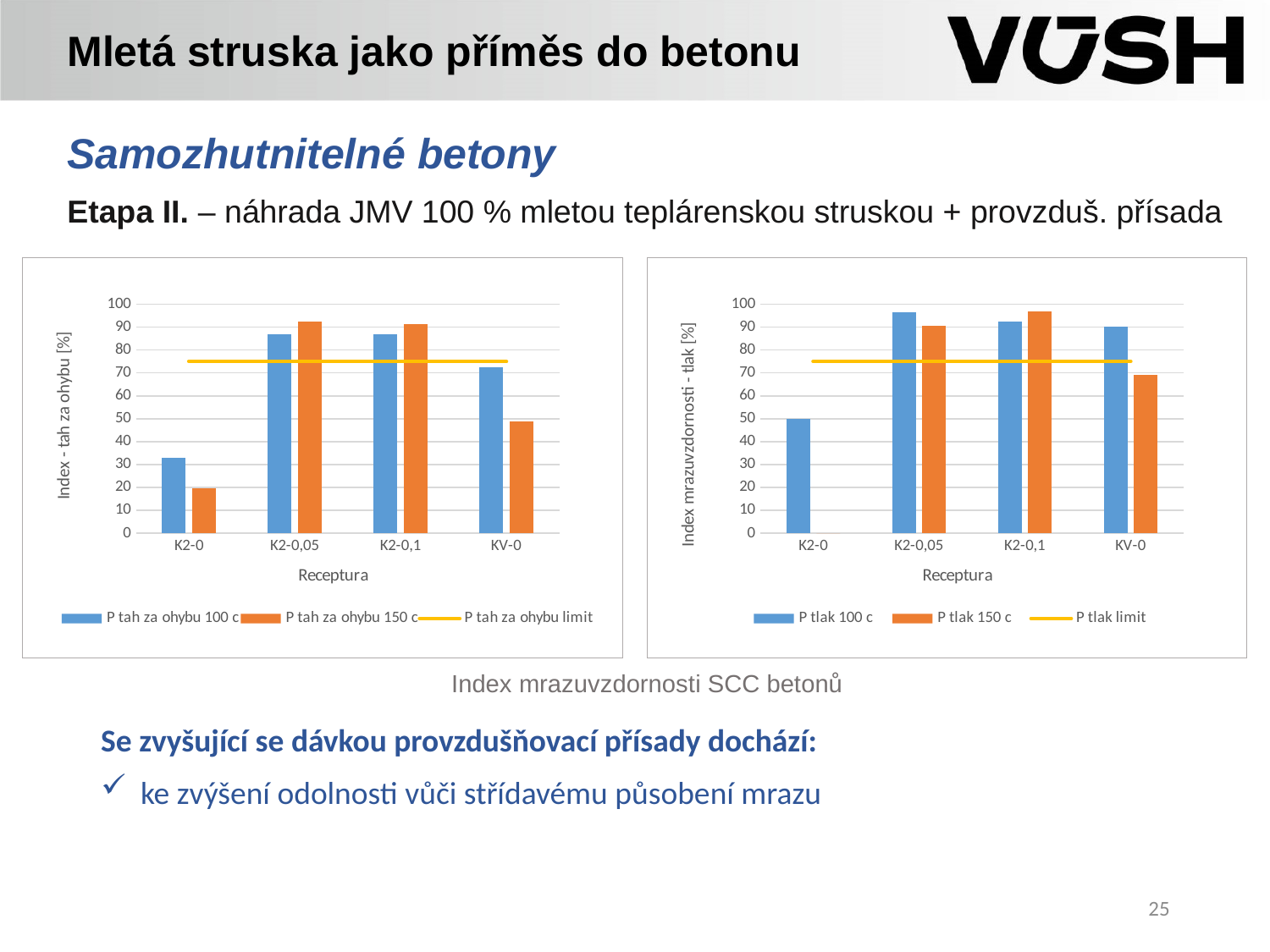
In the right chart, for KV-0, which is larger: P tlak 100 c or P tlak 150 c? P tlak 100 c In the left chart, is the value of P tah za ohybu 150 c for K2-0,05 greater or less than 90? greater In the left chart, which category has the lowest value for P tah za ohybu 150 c? K2-0 In the left chart, for KV-0, which is larger: P tah za ohybu 100 c or P tah za ohybu 150 c? P tah za ohybu 100 c How many categories are shown on the x axis of the right chart? 4 What is the y-axis label of the right chart? Index mrazuvzdornosti - tlak [%] What kind of chart is the left chart on the slide? bar chart In the right chart, which category has the lowest value for P tlak 100 c? K2-0 In the right chart, is the value of P tlak 100 c for K2-0 greater or less than 60? less How many series does the legend of the left chart list? 3 In the right chart, is the value of P tlak 150 c for KV-0 greater or less than 80? less